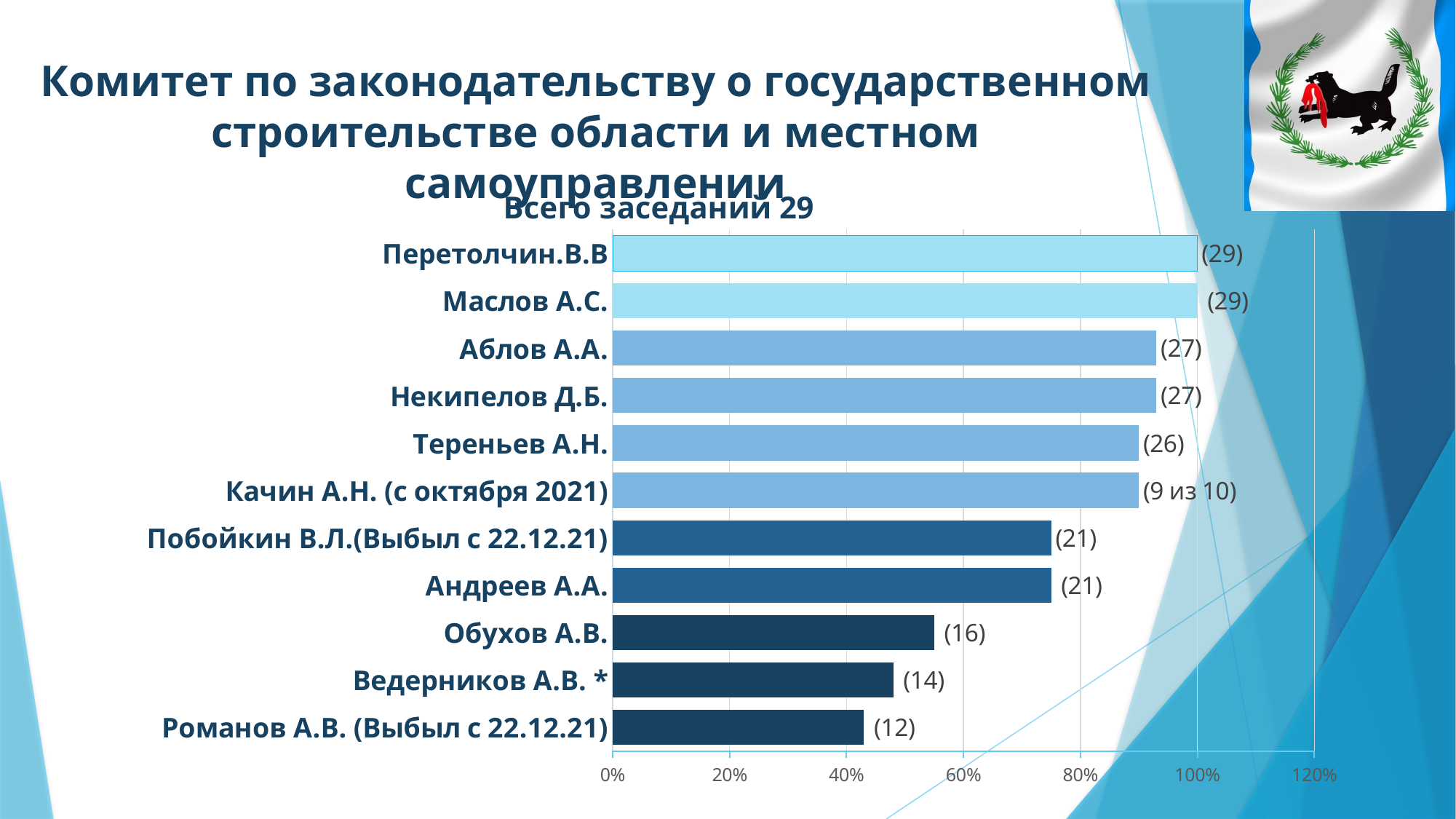
What is the data label shown for Ведерников А.В. *? (14) Is the bar for Обухов А.В. greater or less than 40%? greater What kind of chart is shown on the slide? bar chart Which has a larger value, Андреев А.А. or Ведерников А.В. *? Андреев А.А. What is the data label shown for Качин А.Н. (с октября 2021)? (9 из 10) How many categories (people) are shown in the chart? 11 Is the bar for Теренеьев А.Н. greater or less than 80%? greater What is the data label shown for Обухов А.В.? (16) Is the bar for Романов А.В. (Выбыл с 22.12.21) greater or less than 60%? less What is the difference between the labelled values for Аблов А.А. and Обухов А.В.? 11 Which category has the lowest value in the chart? Романов А.В. (Выбыл с 22.12.21) What is the title of the chart? Всего заседаний 29